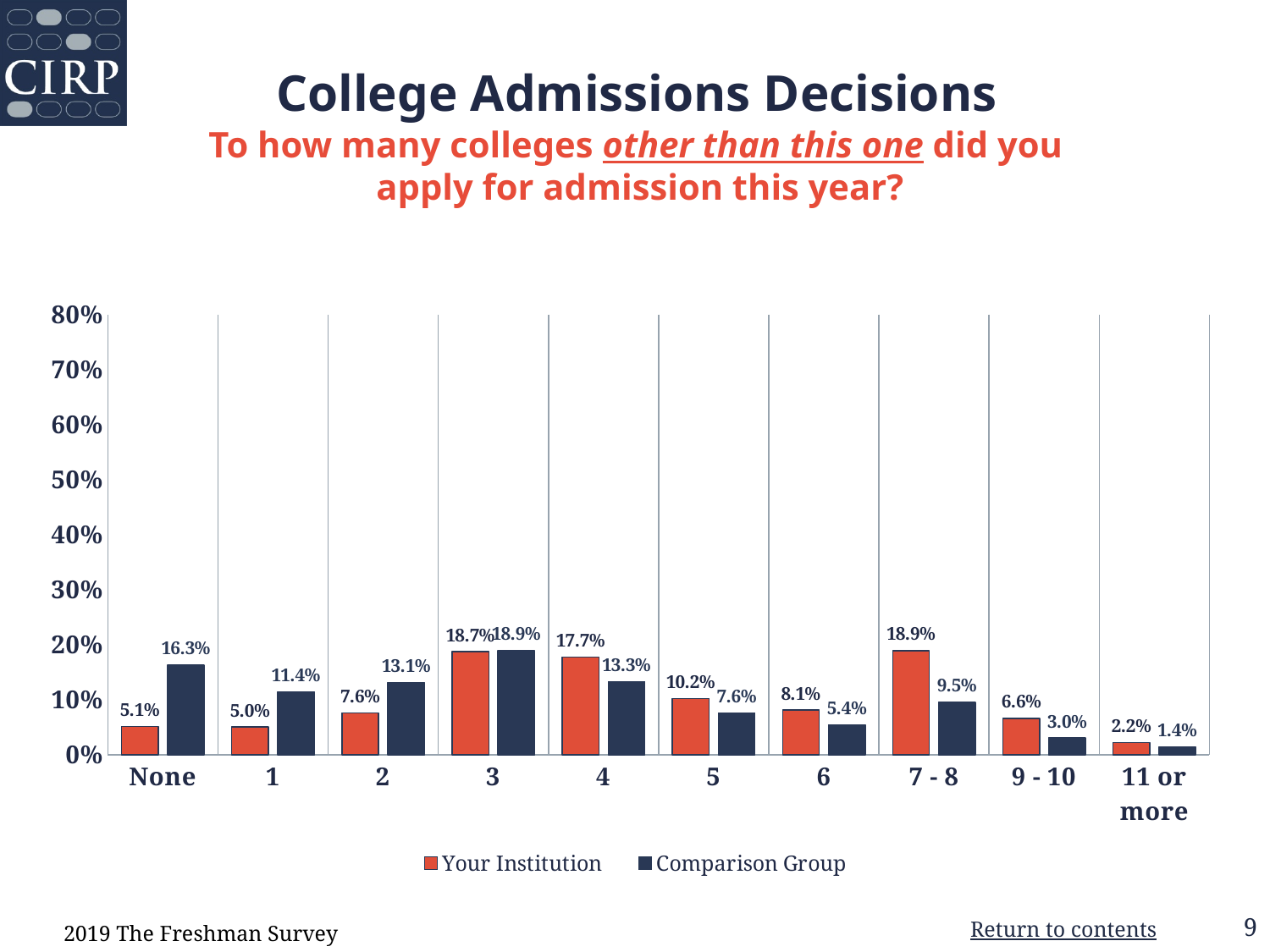
What kind of chart is shown on the slide? Bar chart How many categories are shown on the x axis of the chart? 10 What are the two series named in the legend? Your Institution and Comparison Group What is the difference between the Comparison Group and Your Institution values for the 'None' category? 11.2 percentage points Is the Comparison Group value for 'None' greater or less than 10%? greater How many series does the legend list? 2 What percentage of Your Institution respondents applied to no other colleges (None)? 5.1% Which category has the lowest Your Institution value? 11 or more For the '4' category, which series has the larger value, Your Institution or Comparison Group? Your Institution What is the Comparison Group value for the '7 - 8' category? 9.5% What is the Your Institution value for the '4' category? 17.7% Which category has the highest Comparison Group value? 3